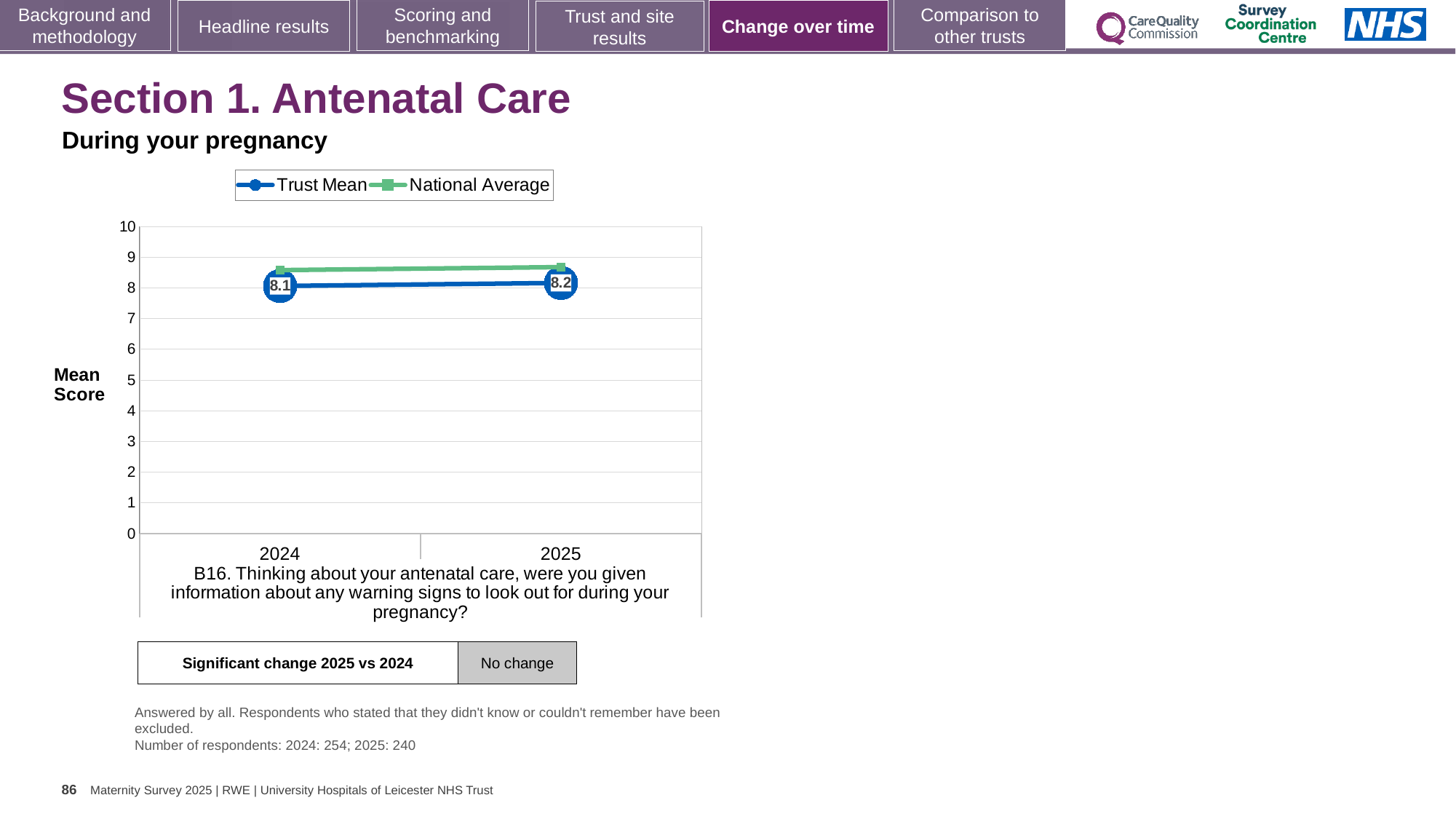
What kind of chart is shown on the slide? line chart What is the Trust Mean score for 2024? 8.1 Is the National Average value for 2025 greater or less than 9? less Is the National Average value for 2024 greater or less than 8? greater How many years are plotted on the x axis? 2 In which year is the Trust Mean score higher, 2024 or 2025? 2025 What is the label on the y axis of the chart? Mean Score Does the Trust Mean rise or fall from 2024 to 2025? rise How many series does the legend list? 2 What is the Trust Mean score for 2025? 8.2 What is the difference between the Trust Mean scores for 2025 and 2024? 0.1 In 2024, which is higher, the Trust Mean or the National Average? National Average